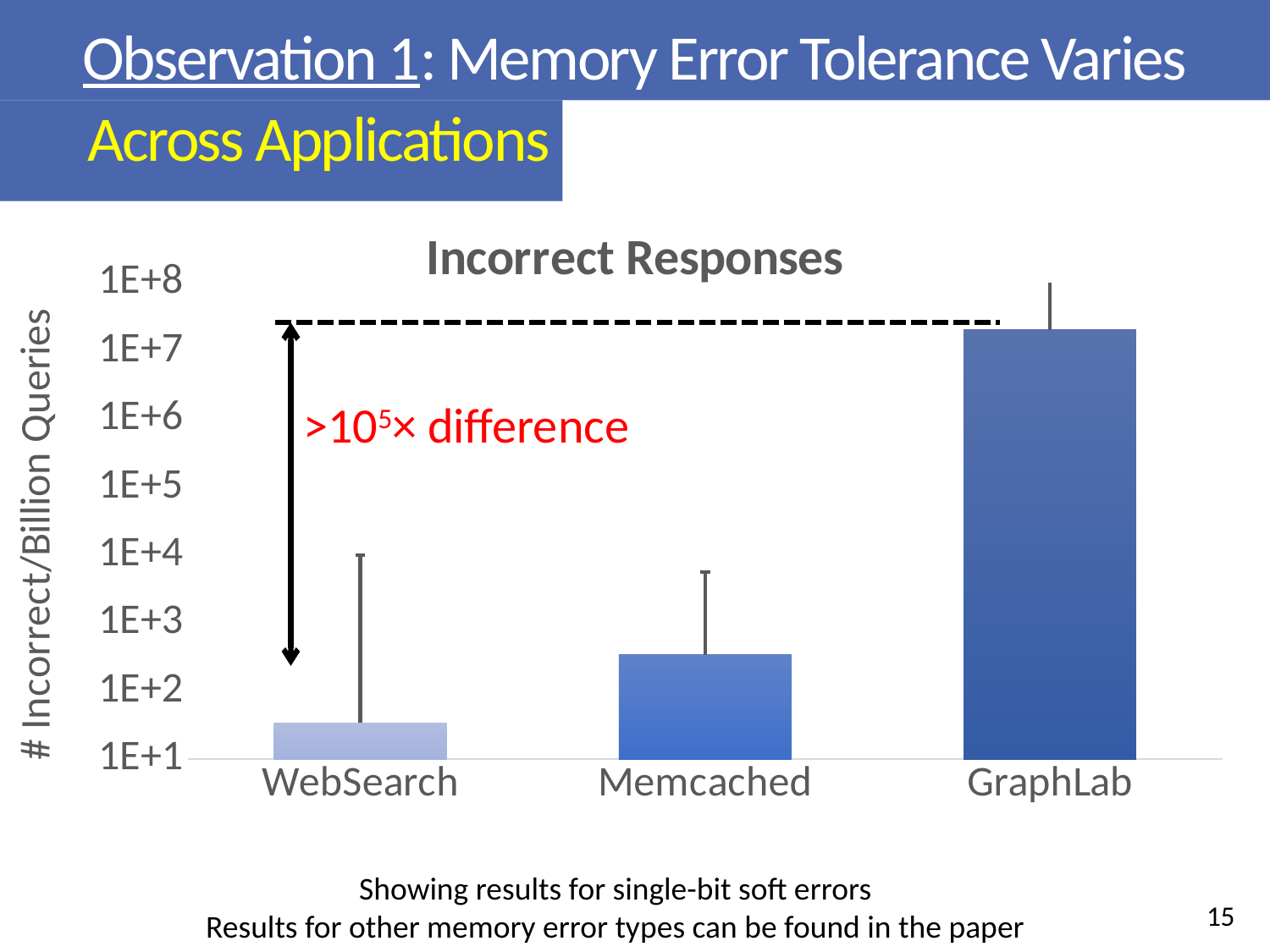
Which application has the highest number of incorrect responses per billion queries? GraphLab Which has more incorrect responses per billion queries, Memcached or WebSearch? Memcached Which application has the lowest number of incorrect responses per billion queries? WebSearch Is the value for Memcached greater or less than 1E+2? greater What kind of chart is shown on the slide? bar chart What is the title of the chart? Incorrect Responses Is the value for WebSearch greater or less than 1E+2? less How many applications (categories) are plotted on the x axis? 3 Which has more incorrect responses per billion queries, GraphLab or Memcached? GraphLab Is the value for GraphLab greater or less than 1E+7? greater What is the label on the vertical axis of the chart? # Incorrect/Billion Queries